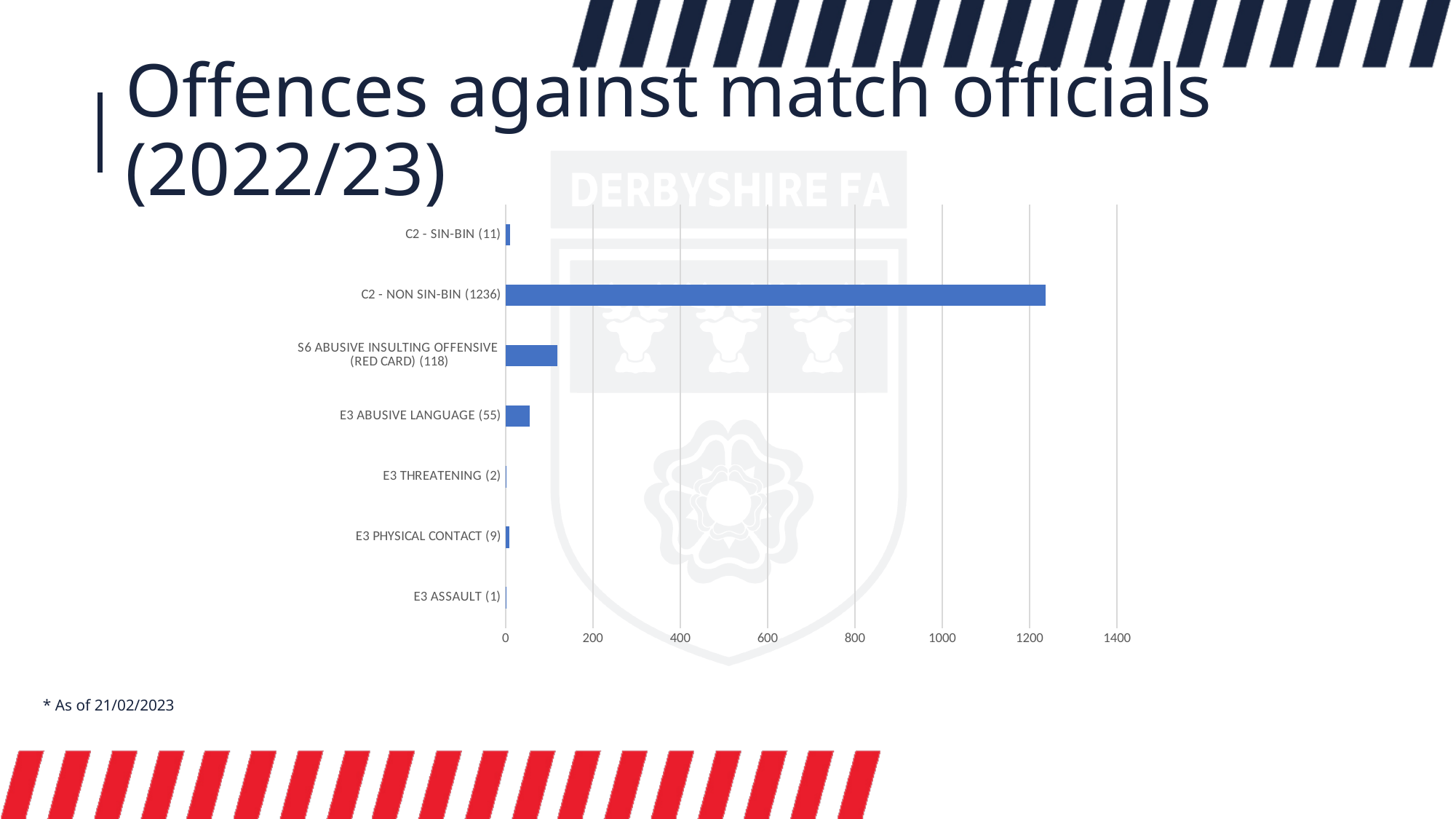
What is the title of the slide containing the chart? Offences against match officials (2022/23) Which category has the highest value? C2 - NON SIN-BIN What is the value for E3 ABUSIVE LANGUAGE? 55 Which category has the lowest value? E3 ASSAULT What is the value for E3 PHYSICAL CONTACT? 9 How many categories are plotted in the chart? 7 What type of chart is shown on the slide? Bar chart What is the value for C2 - NON SIN-BIN? 1236 What is the value for S6 ABUSIVE INSULTING OFFENSIVE (RED CARD)? 118 What is the difference between the values for C2 - NON SIN-BIN and S6 ABUSIVE INSULTING OFFENSIVE (RED CARD)? 1118 Is the value for C2 - NON SIN-BIN greater or less than 1000? greater Which is larger, the value for E3 ABUSIVE LANGUAGE or the value for C2 - SIN-BIN? E3 ABUSIVE LANGUAGE